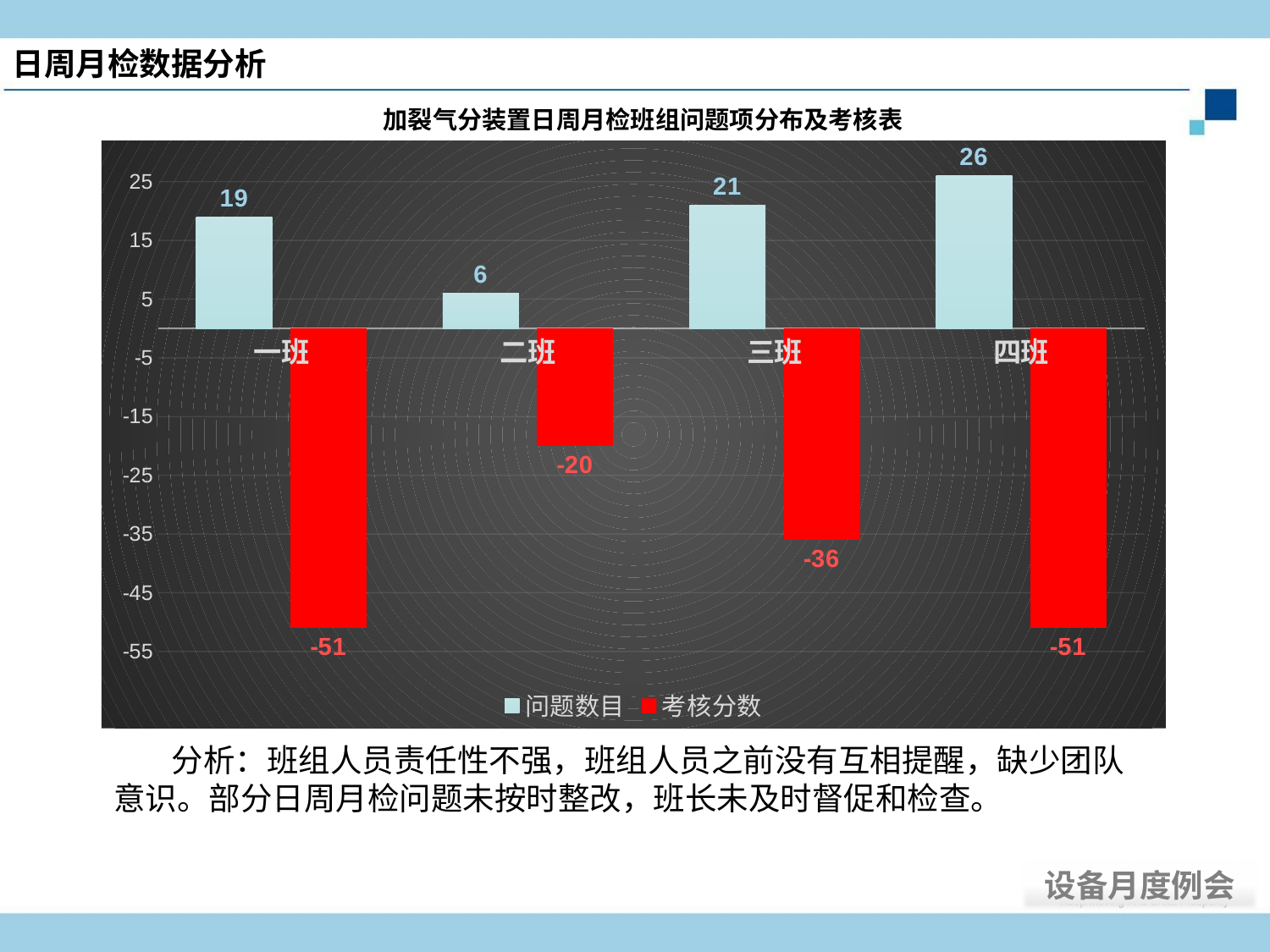
What is the 考核分数 value for 三班? -36 How many series does the legend list? 2 What is the difference between the 问题数目 values for 四班 and 二班? 20 What kind of chart is shown on the slide? bar chart Which has a larger 问题数目, 一班 or 三班? 三班 Which category has the lowest 问题数目? 二班 How many categories are shown on the x axis? 4 What is the 考核分数 value for 二班? -20 Which category has the highest 问题数目? 四班 What is the 问题数目 value for 一班? 19 Which colour represents the 考核分数 series? red What is the title of the chart? 加裂气分装置日周月检班组问题项分布及考核表